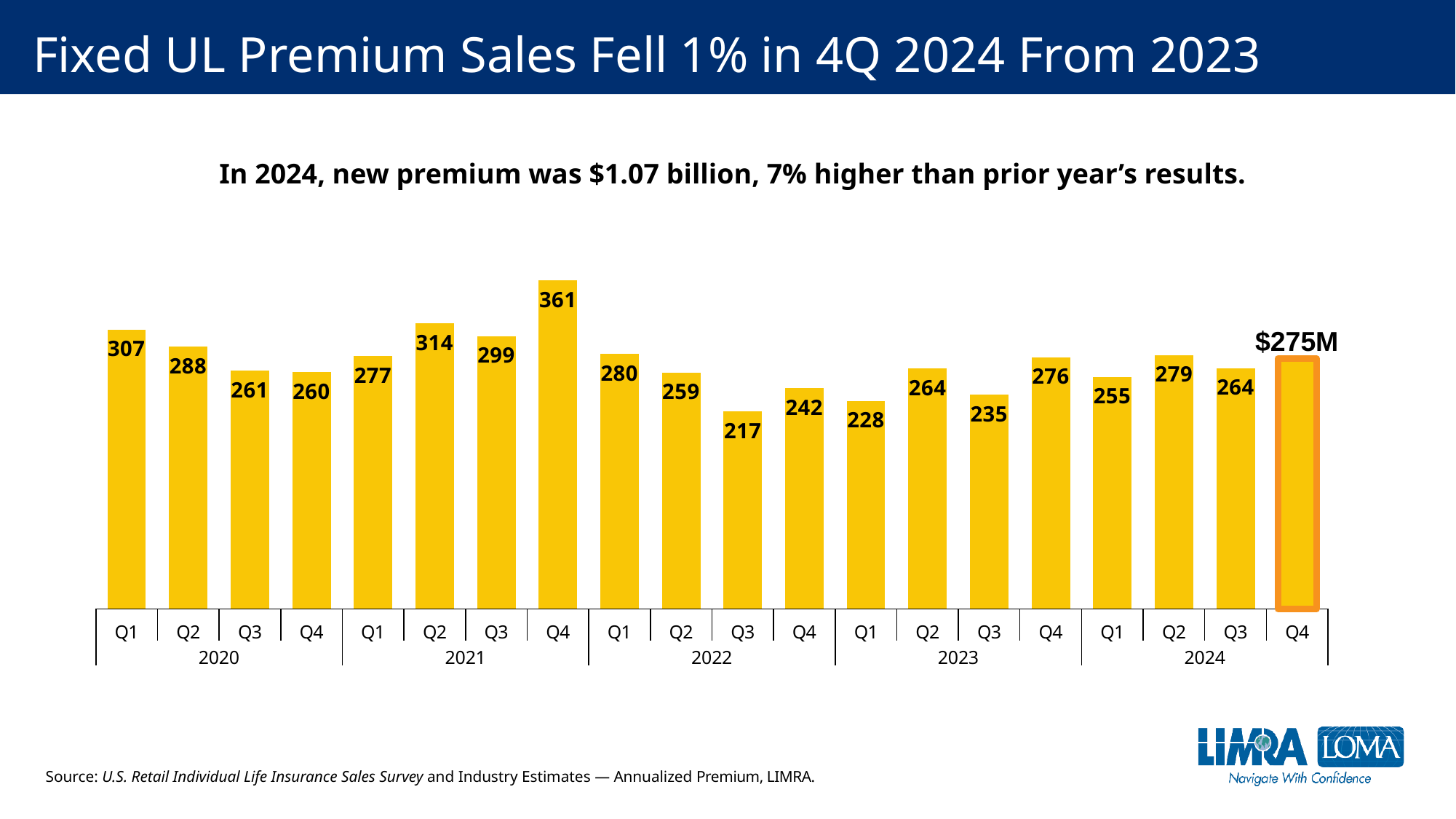
What is the difference between Q4 2021 and Q3 2022? 144 What is the value for Q4 2024? $275M Which quarter has the lowest value? Q3 2022 How many quarterly bars are plotted on the chart? 20 Do the values rise or fall from Q1 2022 to Q3 2022? Fall What is the value for Q3 2022? 217 Which quarter has the highest value? Q4 2021 Which is larger, Q1 2020 or Q2 2021? Q2 2021 What kind of chart is shown on the slide? Bar chart What is the difference between Q2 2024 and Q1 2024? 24 What is the value for Q1 2020? 307 What is the value for Q4 2021? 361